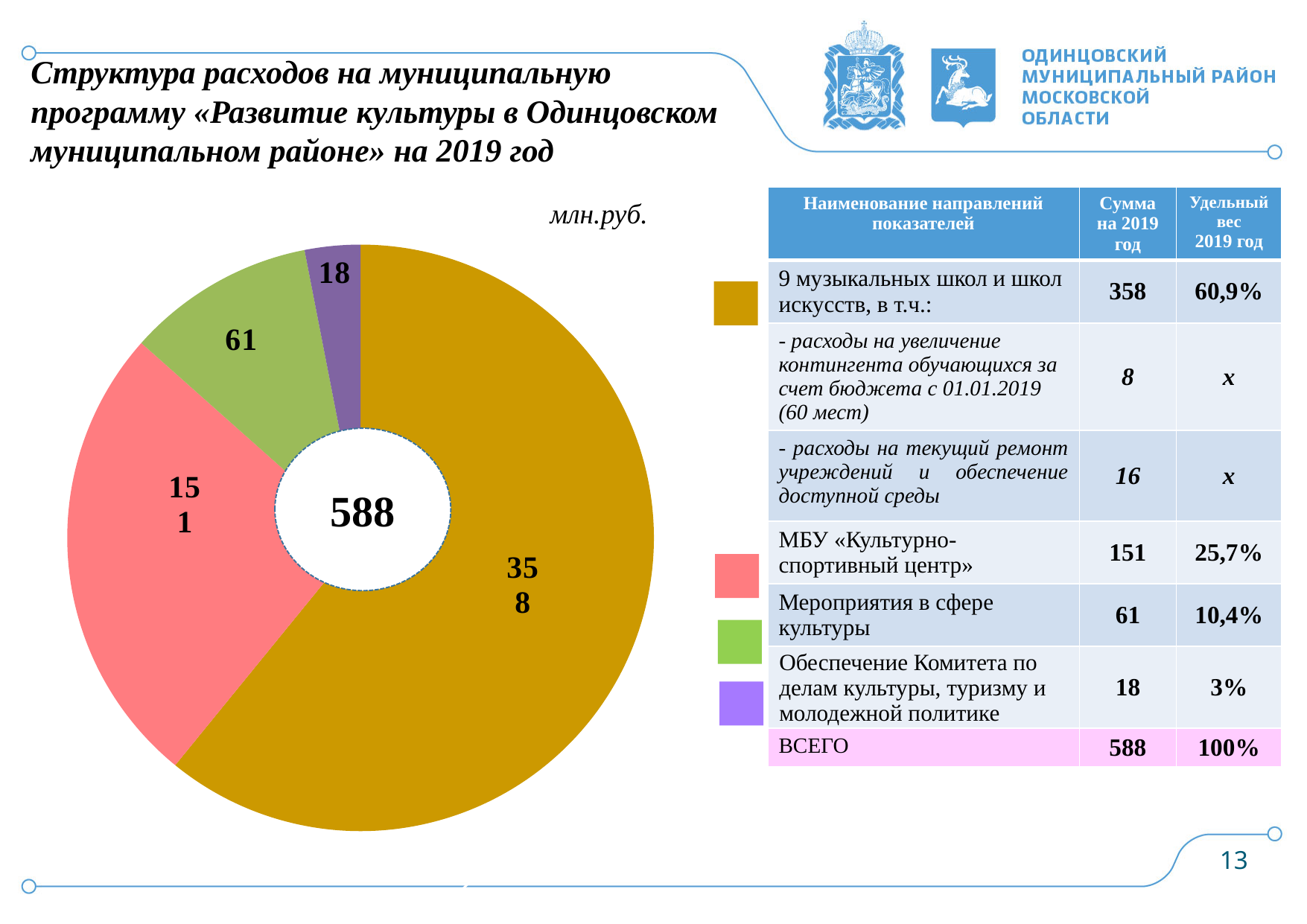
Which category has the smallest slice of the pie? Обеспечение Комитета по делам культуры, туризму и молодежной политике What kind of chart is shown on the slide? pie chart What value is shown for the slice for Обеспечение Комитета по делам культуры, туризму и молодежной политике? 18 What share of the pie does the slice for 9 музыкальных школ и школ искусств represent? 60,9% Which slice is larger: Мероприятия в сфере культуры or Обеспечение Комитета по делам культуры, туризму и молодежной политике? Мероприятия в сфере культуры What total value is shown in the centre of the pie chart? 588 How many slices does the pie chart have? 4 What value is shown for the slice for Мероприятия в сфере культуры? 61 Which category has the largest slice of the pie? 9 музыкальных школ и школ искусств What value is shown for the slice for МБУ «Культурно-спортивный центр»? 151 What is the difference between the slice for 9 музыкальных школ и школ искусств and the slice for МБУ «Культурно-спортивный центр»? 207 In what units are the values of the pie chart given? млн.руб.